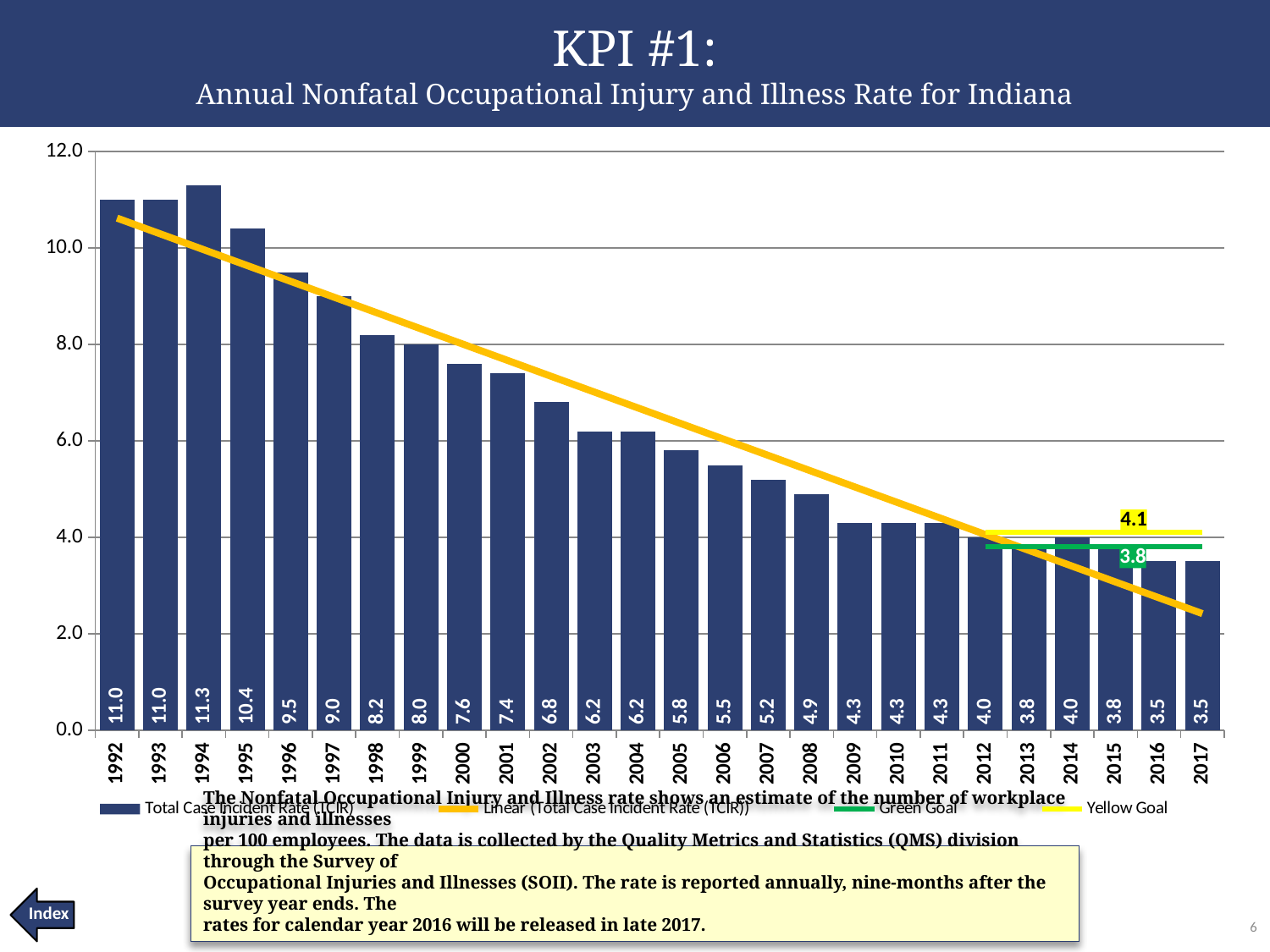
Which year has the larger Total Case Incident Rate, 1995 or 1996? 1995 What is the Total Case Incident Rate for 2008? 4.9 What is the Total Case Incident Rate for 2017? 3.5 Which year has the highest Total Case Incident Rate? 1994 What is the difference between the Total Case Incident Rate in 2002 and in 2003? 0.6 What is the Total Case Incident Rate for 1994? 11.3 Is the Total Case Incident Rate for 2000 greater or less than 8.0? less How many entries does the chart legend list? 4 Does the Total Case Incident Rate generally rise or fall from 1992 to 2017? Fall What is the difference between the Total Case Incident Rate in 1992 and in 2017? 7.5 What kind of chart is used to show the Total Case Incident Rate? Bar chart How many years are shown on the x axis of the chart? 26